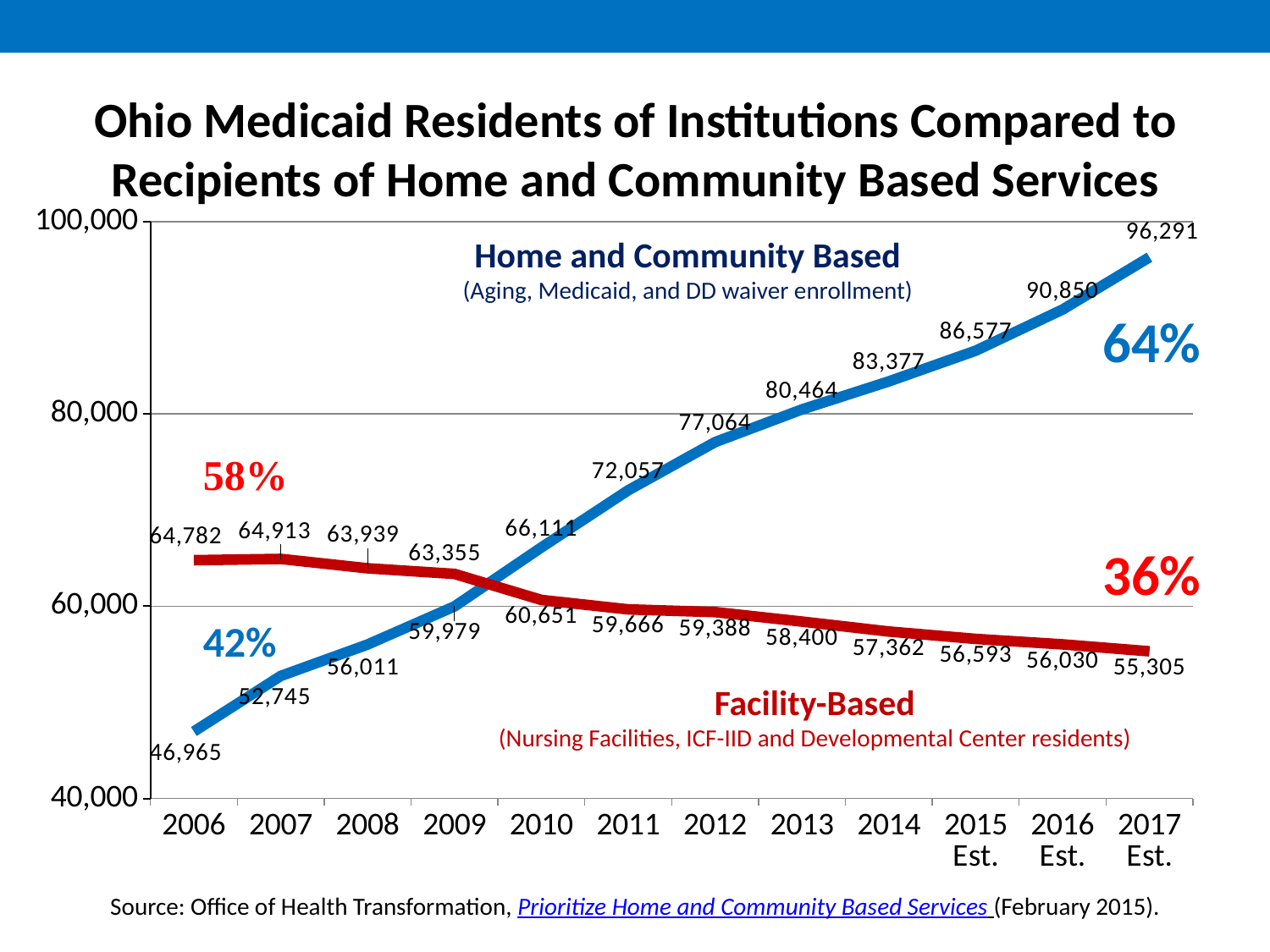
How many years are shown on the x axis? 12 What is the Home and Community Based value for 2006? 46,965 What is the Facility-Based value for 2017 Est.? 55,305 Does the Facility-Based series rise or fall from 2009 to 2017 Est.? Fall What is the Facility-Based value for 2009? 63,355 What is the Home and Community Based value for 2012? 77,064 Which series has the larger value in 2008, Home and Community Based or Facility-Based? Facility-Based What percentage is shown in blue next to the end of the Home and Community Based line? 64% In which year does the Home and Community Based series reach its highest value? 2017 Est. What is the difference between the Home and Community Based value and the Facility-Based value in 2017 Est.? 40,986 What kind of chart is shown on the slide? Line chart In which year is the Facility-Based series at its lowest value? 2017 Est.